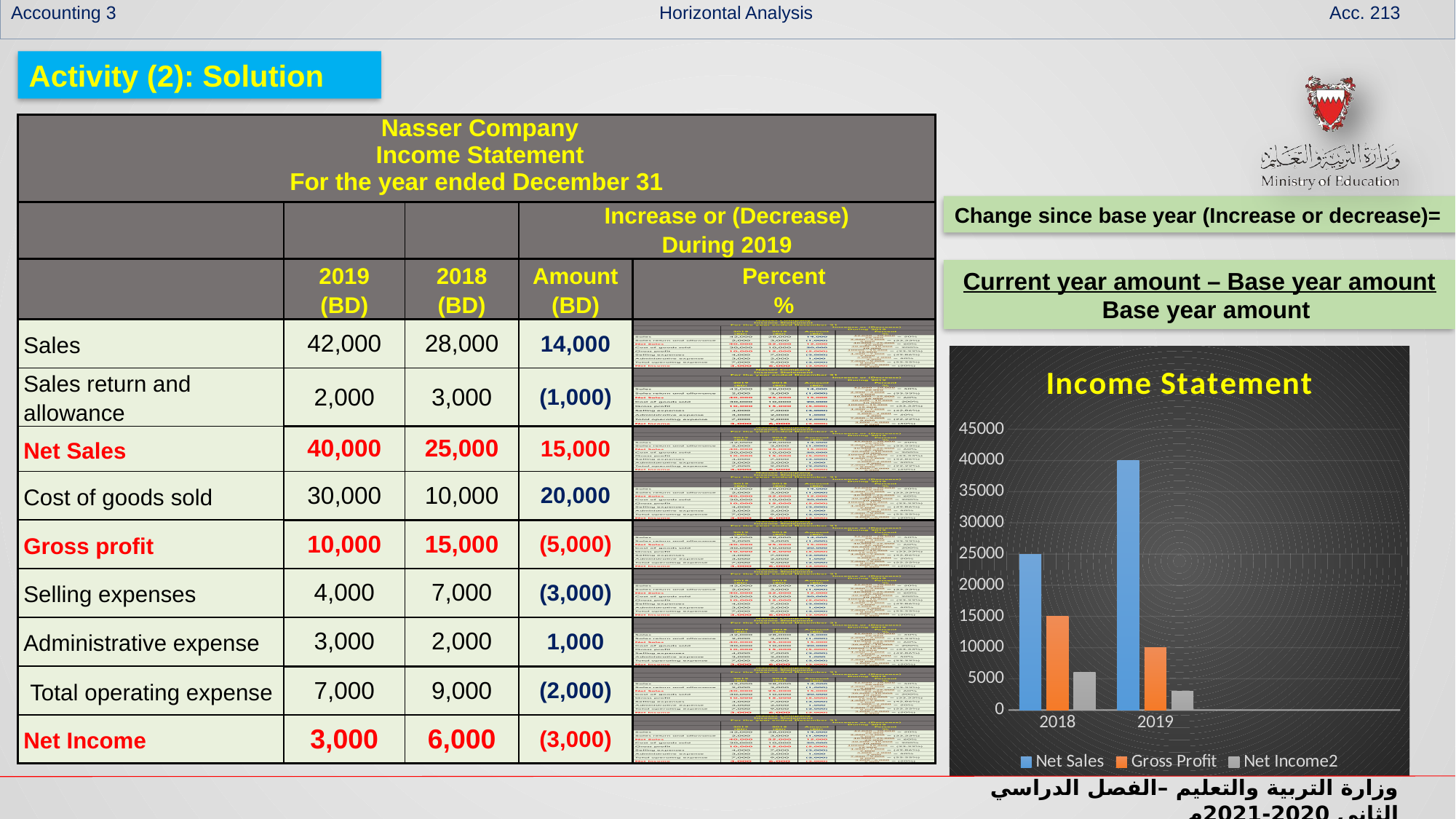
In the "Income Statement" chart, which year has the higher Gross Profit, 2018 or 2019? 2018 What kind of chart is the "Income Statement" chart? bar chart How many year categories are shown on the x axis of the "Income Statement" chart? 2 How many series does the legend of the "Income Statement" chart list? 3 In the "Income Statement" chart, is the Net Income2 value for 2018 greater or less than 5000? greater In the "Income Statement" chart, which series is the tallest bar in 2019? Net Sales In the "Income Statement" chart, by how much did Net Sales increase from 2018 to 2019? 15000 In the "Income Statement" chart, what is the Gross Profit value for 2018? 15000 In the "Income Statement" chart, what is the Net Sales value for 2018? 25000 In the "Income Statement" chart, what is the Gross Profit value for 2019? 10000 In the "Income Statement" chart, is the Net Income2 value for 2019 greater or less than 5000? less In the "Income Statement" chart, what is the Net Sales value for 2019? 40000